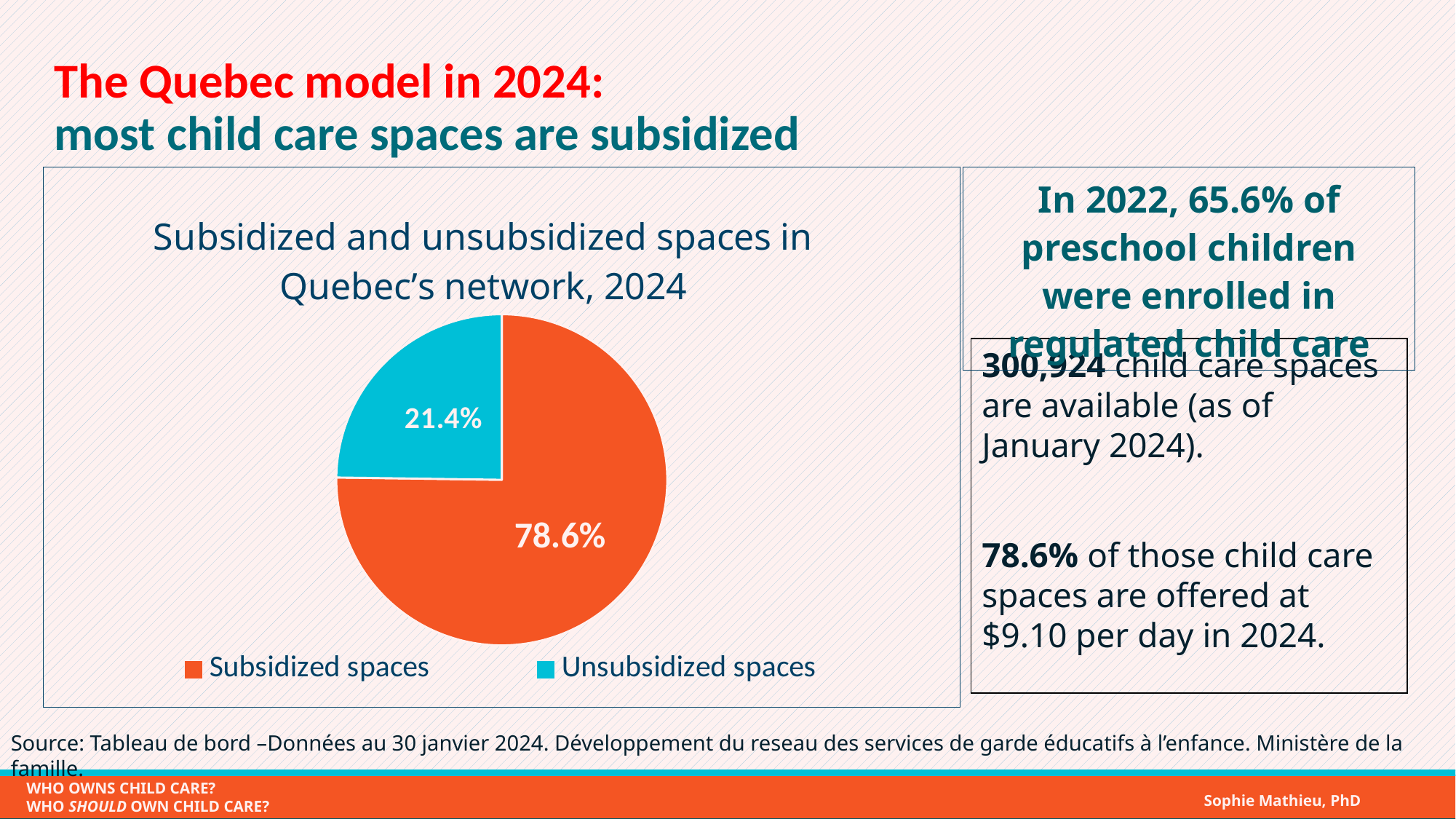
Which slice of the pie is the largest? Subsidized spaces How many slices does the pie chart have? 2 How many entries does the legend list? 2 What is the difference in percentage points between Subsidized spaces and Unsubsidized spaces? 57.2 What type of chart is shown on the slide? pie chart Which is larger, the share for Subsidized spaces or the share for Unsubsidized spaces? Subsidized spaces What is the title of the chart? Subsidized and unsubsidized spaces in Quebec's network, 2024 What colour is the Unsubsidized spaces slice? cyan Which slice of the pie is the smallest? Unsubsidized spaces What share of the pie is Subsidized spaces? 78.6% What share of the pie is Unsubsidized spaces? 21.4%